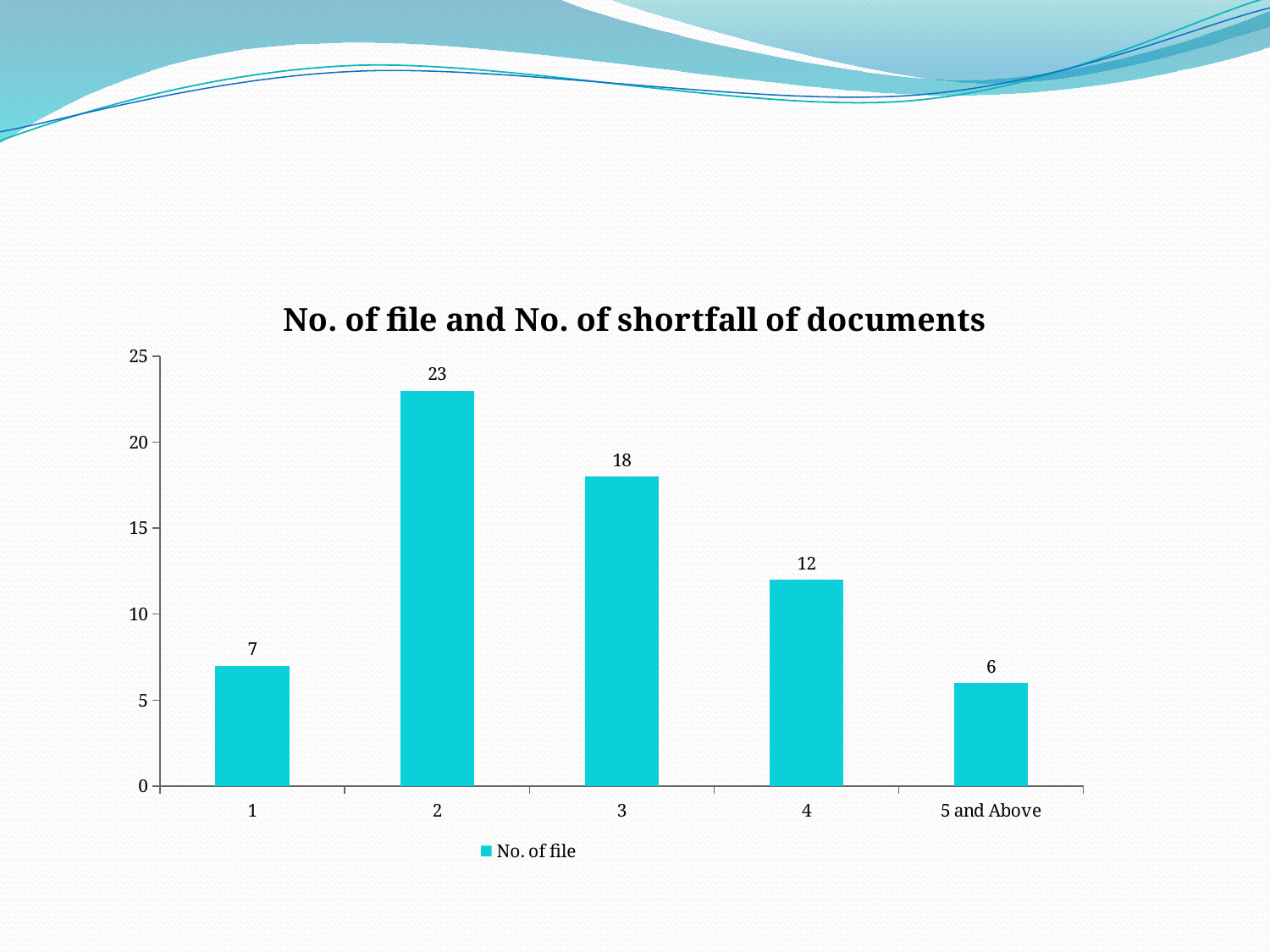
What is the value for the '5 and Above' category? 6 Which category has the highest value? 2 What is the value for category 2? 23 Which is larger, the value for category 3 or the value for category 4? 3 How many categories are shown on the x axis? 5 What kind of chart is shown on the slide? bar chart What is the difference between the values for category 2 and category 3? 5 What is the difference between the values for category 1 and category 4? 5 What is the title of the chart? No. of file and No. of shortfall of documents What is the value for category 4? 12 Is the value for category 3 greater or less than 15? greater Which category has the lowest value? 5 and Above